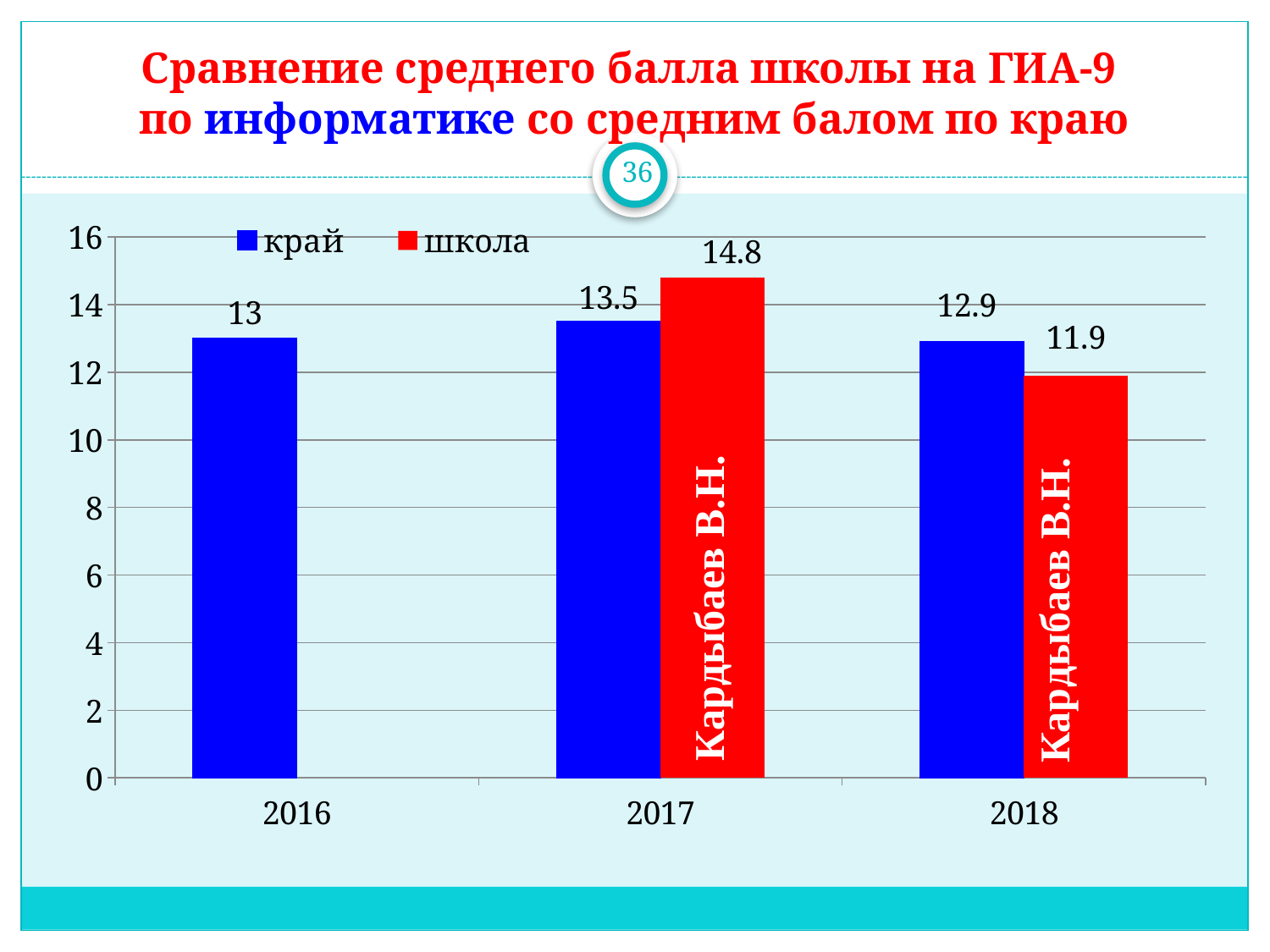
How many years are shown on the x axis? 3 What is the difference between школа and край in 2017? 1.3 What kind of chart is shown on the slide? bar chart How many series does the legend list? 2 Which is larger in 2018, край or школа? край What is the value for школа in 2017? 14.8 What is the value for край in 2018? 12.9 What is the value for школа in 2018? 11.9 What is the difference between край and школа in 2018? 1 In which year is the value for край highest? 2017 What is the value for край in 2016? 13 In which year is the value for край lowest? 2018